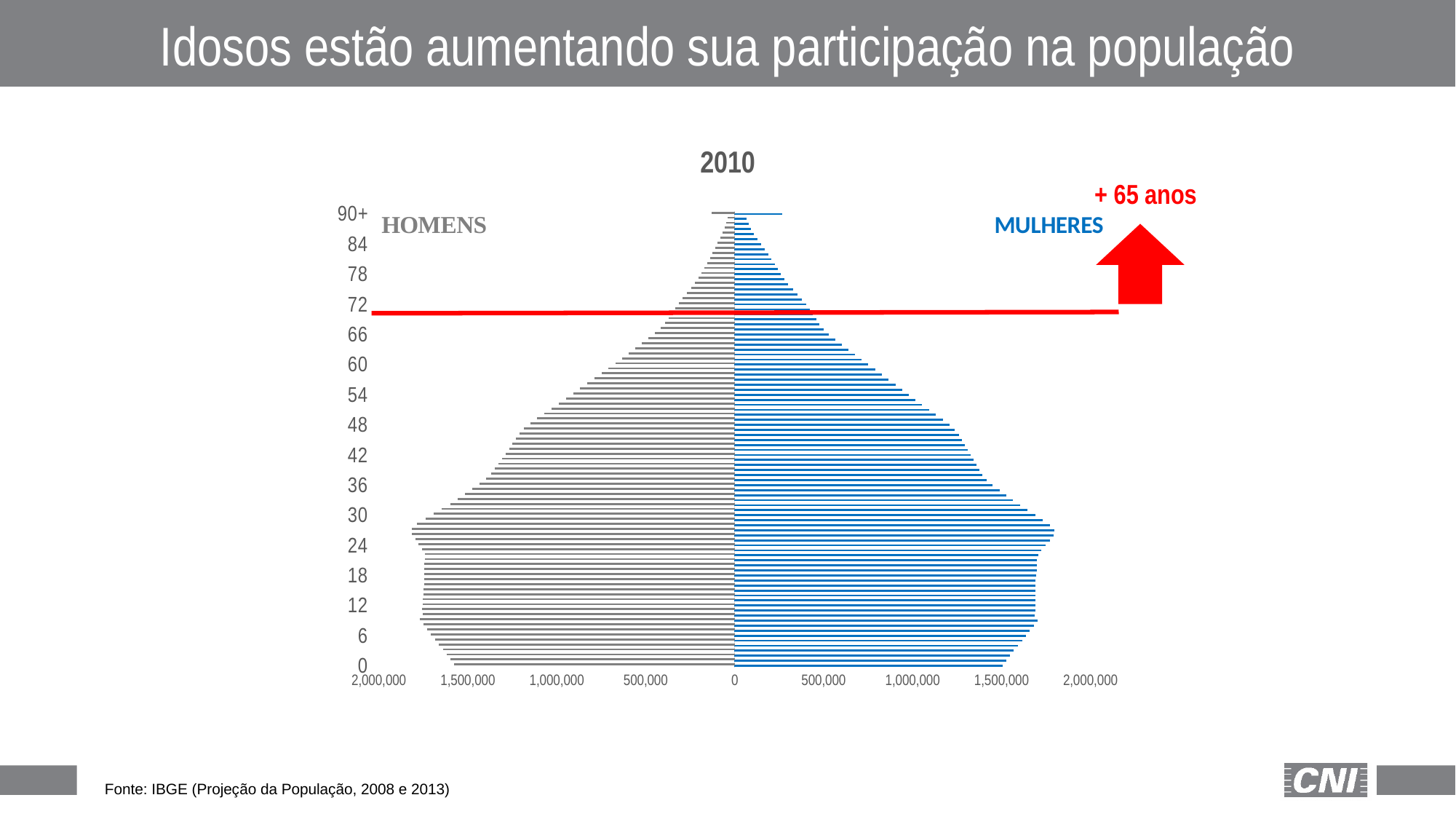
Is the value for MULHERES at age 30 greater or less than 1,500,000? greater Is the value for MULHERES at age 60 greater or less than 1,000,000? less Is the value for HOMENS at age 72 greater or less than 500,000? less Which series is plotted in blue? MULHERES What is the title of the chart? 2010 How many series does the chart show? 2 Do the bar lengths rise or fall as age increases from 30 to 90+? fall At age 84, which series has the larger value, HOMENS or MULHERES? MULHERES What kind of chart is shown on the slide? bar chart